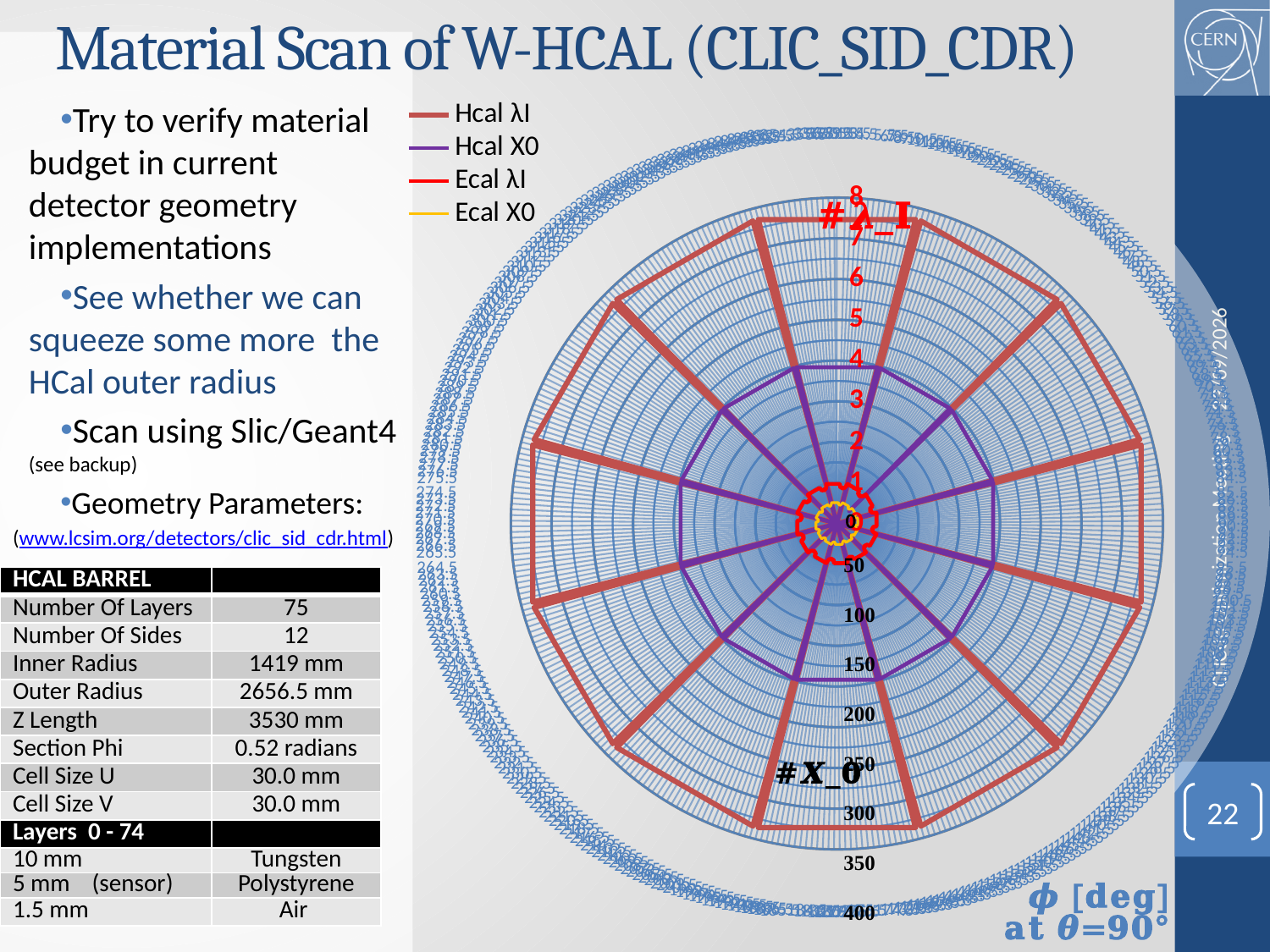
Is the Hcal λI value at its outer vertices greater or less than 4 on the λI scale? greater How many vertices (sides) does the Hcal λI polygon have? 12 What kind of chart is shown on the slide? radar chart Which series stays closest to the centre of the chart? Ecal X0 What are the four series listed in the chart legend? Hcal λI, Hcal X0, Ecal λI, Ecal X0 Which is larger, the Hcal X0 value or the Ecal X0 value? Hcal X0 How many series does the chart legend list? 4 What is the label of the angular axis of the chart? φ [deg] at θ=90° Which series extends farthest from the centre of the chart? Hcal λI What is the highest tick value shown on the λI radial scale? 8 Which is larger, the Hcal λI value or the Ecal λI value? Hcal λI